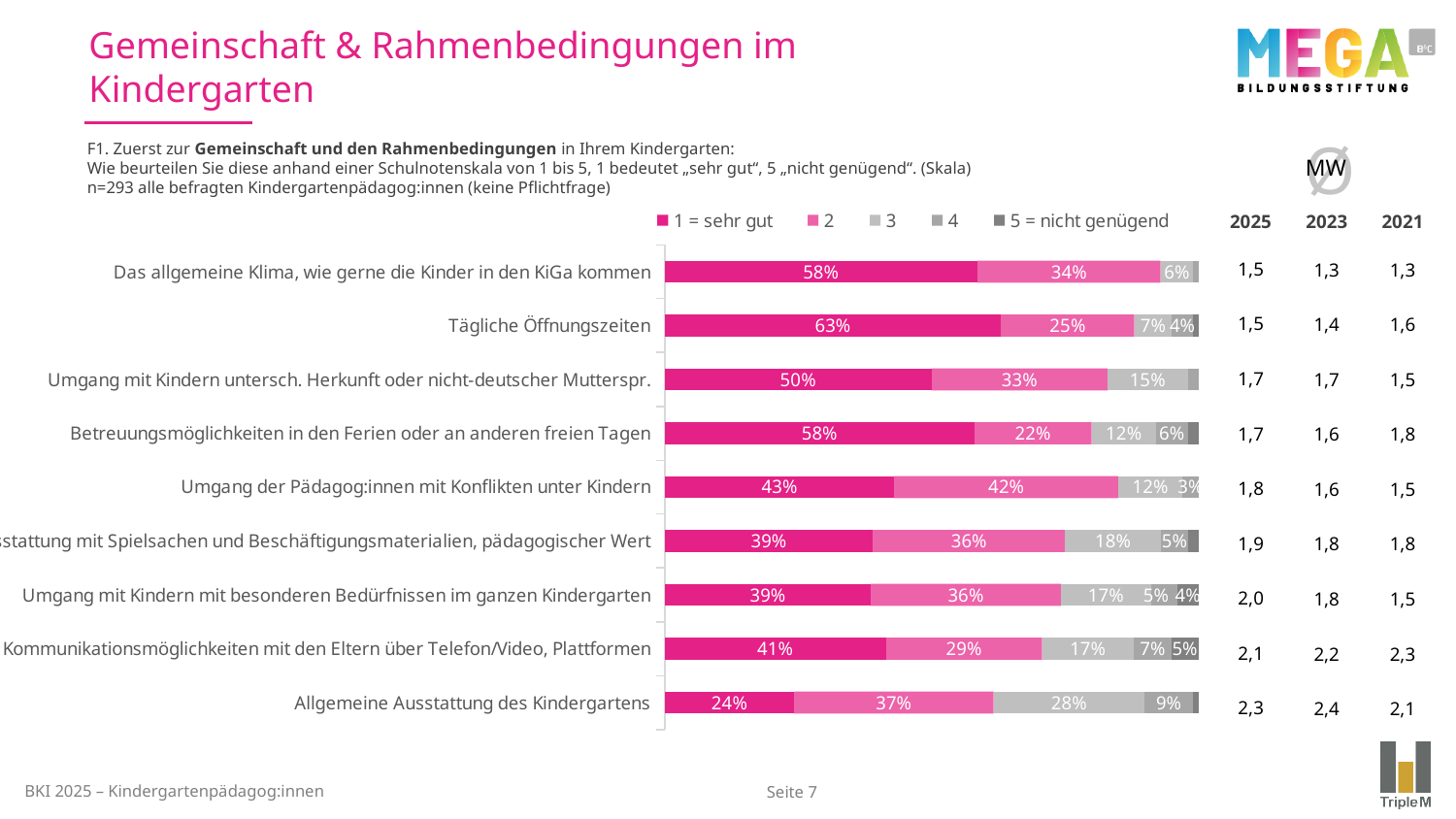
Which category has the lowest share of "1 = sehr gut" ratings? Allgemeine Ausstattung des Kindergartens What is the label of the first series in the chart legend? 1 = sehr gut Which category has the highest share of "1 = sehr gut" ratings? Tägliche Öffnungszeiten What percentage of respondents rated "Das allgemeine Klima, wie gerne die Kinder in den KiGa kommen" with a "2"? 34% What percentage of respondents rated "Tägliche Öffnungszeiten" with "1 = sehr gut"? 63% What percentage of respondents rated "Kommunikationsmöglichkeiten mit den Eltern über Telefon/Video, Plattformen" with a "4"? 7% What kind of chart is shown on the slide? Stacked bar chart How many categories (rows) are plotted in the chart? 9 How many series does the chart legend list? 5 Which has the larger share of "2" ratings: "Umgang der Pädagog:innen mit Konflikten unter Kindern" or "Allgemeine Ausstattung des Kindergartens"? Umgang der Pädagog:innen mit Konflikten unter Kindern By how many percentage points does the "1 = sehr gut" share for "Tägliche Öffnungszeiten" exceed that for "Allgemeine Ausstattung des Kindergartens"? 39 percentage points What percentage of respondents rated "Allgemeine Ausstattung des Kindergartens" with a "3"? 28%